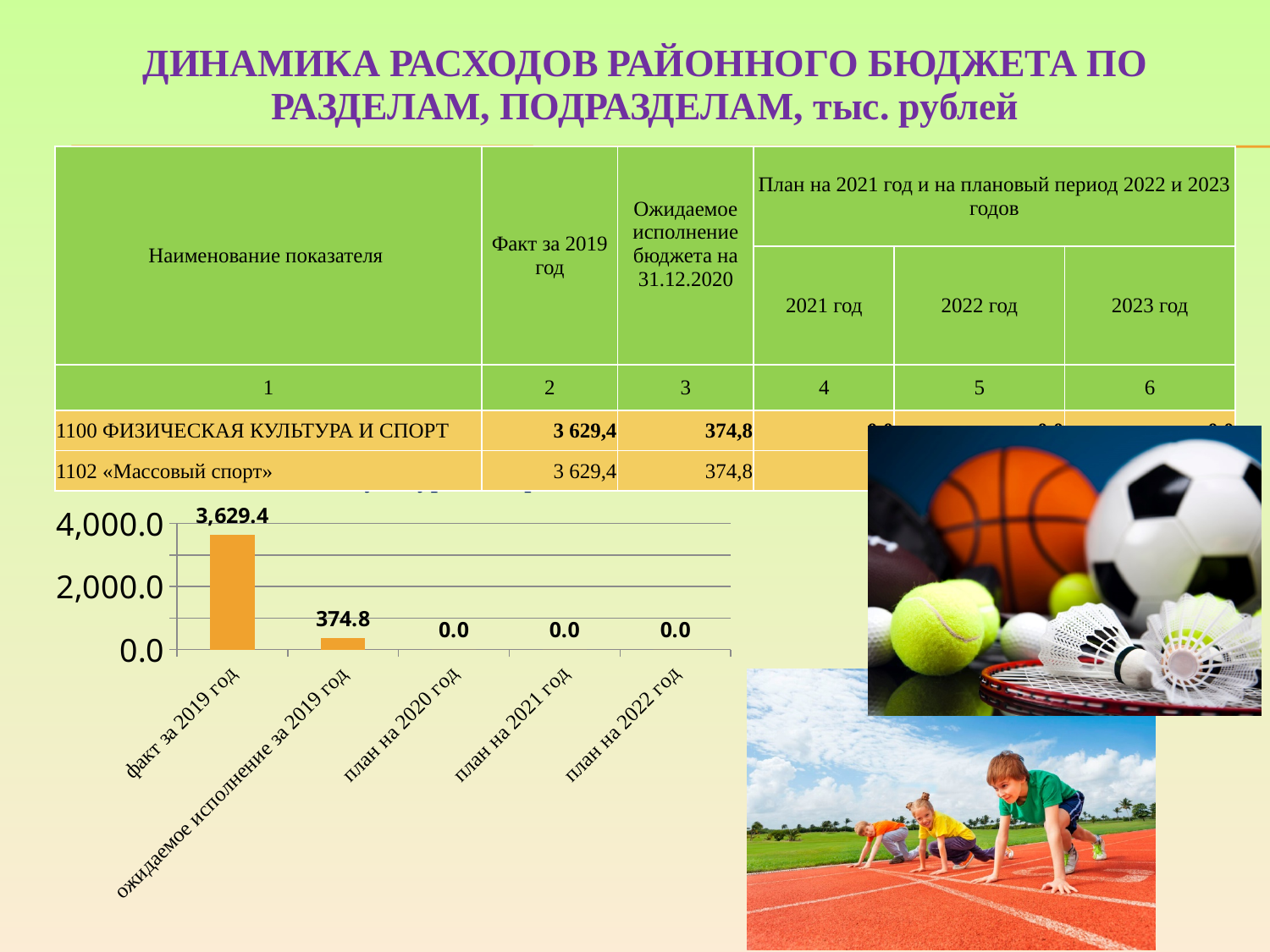
What kind of chart is shown on the slide? bar chart What is the value for факт за 2019 год in the bar chart? 3,629.4 Is the value for ожидаемое исполнение за 2019 год in the bar chart greater or less than 2,000.0? less What is the value for план на 2021 год in the bar chart? 0.0 Do the values in the bar chart rise or fall from left to right along the x axis? fall How many categories are shown on the x axis of the bar chart? 5 Which category has the highest value in the bar chart? факт за 2019 год How many categories in the bar chart have a value of 0.0? 3 Is the value for факт за 2019 год in the bar chart greater or less than 2,000.0? greater What is the difference between the values for факт за 2019 год and ожидаемое исполнение за 2019 год in the bar chart? 3,254.6 Which is larger in the bar chart: факт за 2019 год or ожидаемое исполнение за 2019 год? факт за 2019 год What is the value for ожидаемое исполнение за 2019 год in the bar chart? 374.8